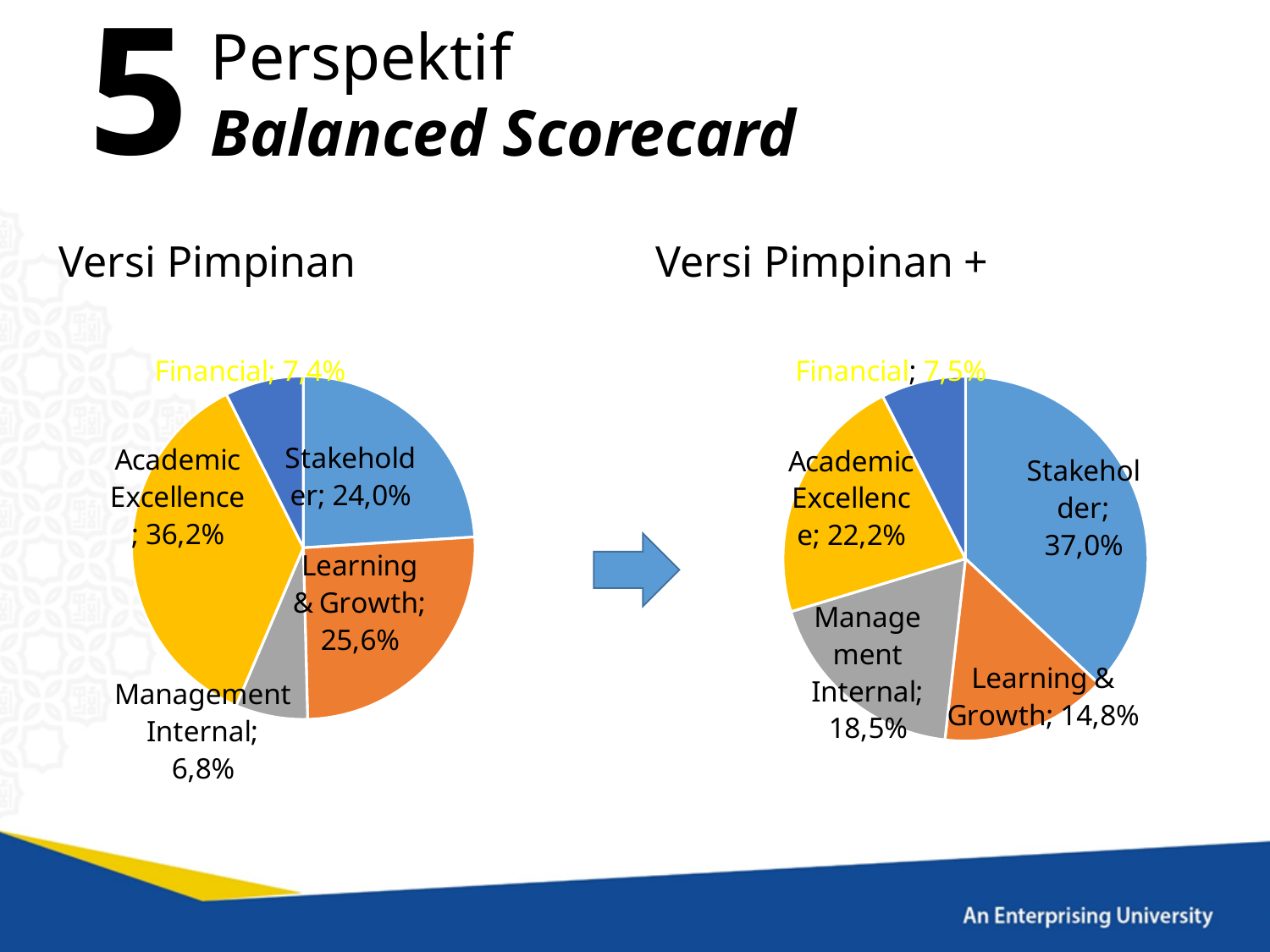
In the 'Versi Pimpinan +' pie chart, what is the share for Learning & Growth? 14,8% In the 'Versi Pimpinan' pie chart, what colour is the Academic Excellence slice? Yellow In the 'Versi Pimpinan' pie chart, what is the share for Academic Excellence? 36,2% In the 'Versi Pimpinan' pie chart, what is the share for Management Internal? 6,8% In the 'Versi Pimpinan' pie chart, which category has the smallest share? Management Internal In the 'Versi Pimpinan' pie chart, which is larger: Learning & Growth or Stakeholder? Learning & Growth In the 'Versi Pimpinan +' pie chart, what is the difference between the Stakeholder share and the Academic Excellence share? 14,8% In the 'Versi Pimpinan' pie chart, which category has the largest share? Academic Excellence In the 'Versi Pimpinan +' pie chart, which category has the smallest share? Financial In the 'Versi Pimpinan +' pie chart, what is the share for Stakeholder? 37,0% What type of chart is used for 'Versi Pimpinan'? Pie chart How many slices does the 'Versi Pimpinan +' pie chart have? 5